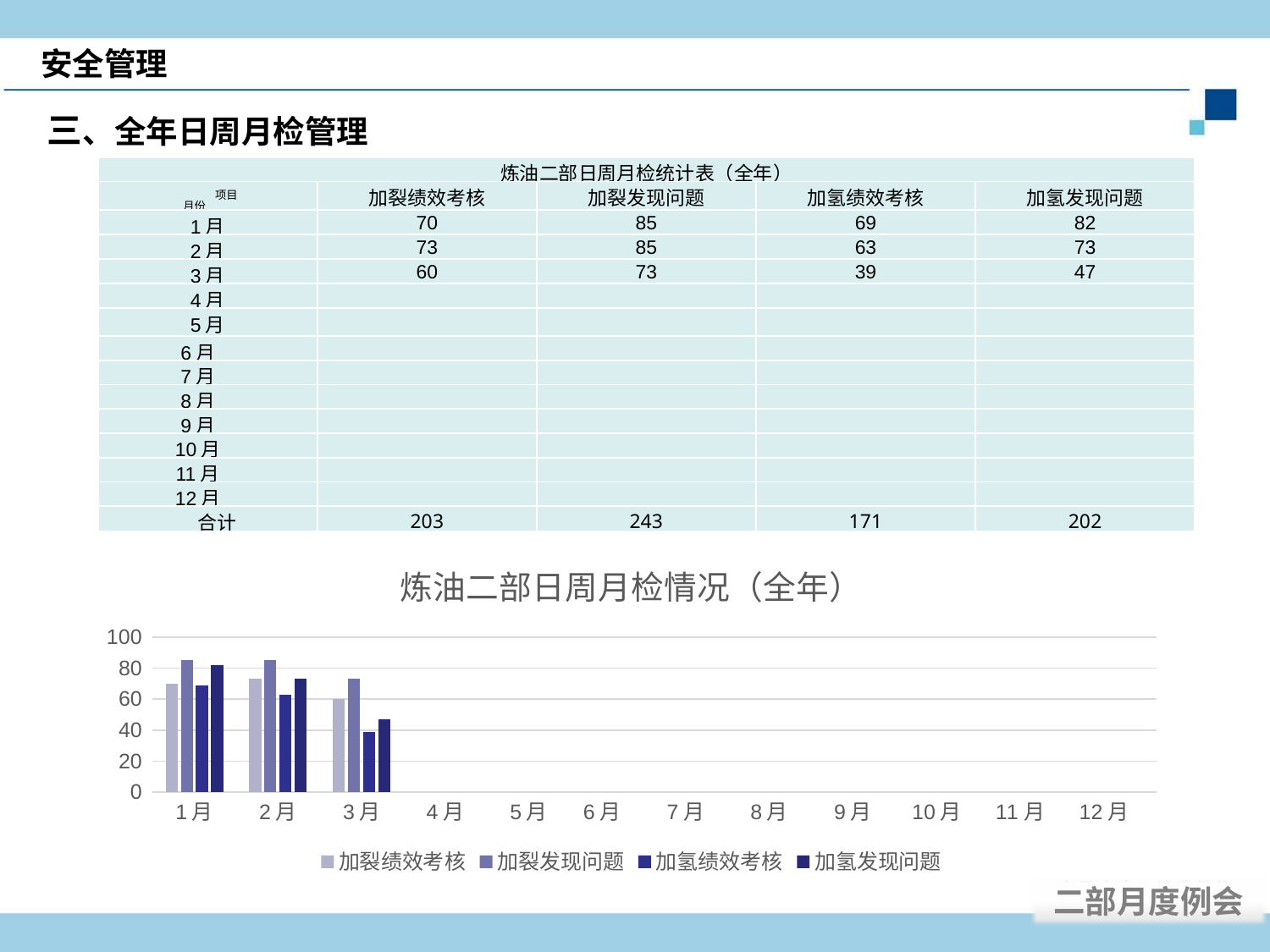
What is the value of 加氢绩效考核 for 3月? 39 In 3月, which series has the highest bar? 加裂发现问题 What is the difference between 加裂发现问题 and 加氢绩效考核 in 1月? 16 Does the value of 加氢绩效考核 rise or fall from 1月 to 3月? fall For how many months does the chart show plotted bars? 3 How many series does the legend of the chart list? 4 How many month categories are shown on the x axis of the chart? 12 What is the value of 加裂发现问题 for 1月? 85 Is the value for 加氢发现问题 in 3月 greater or less than 60? less Which is larger for 加氢发现问题: the value in 1月 or the value in 2月? 1月 What kind of chart is shown on the slide? bar chart In 3月, which series has the lowest bar? 加氢绩效考核